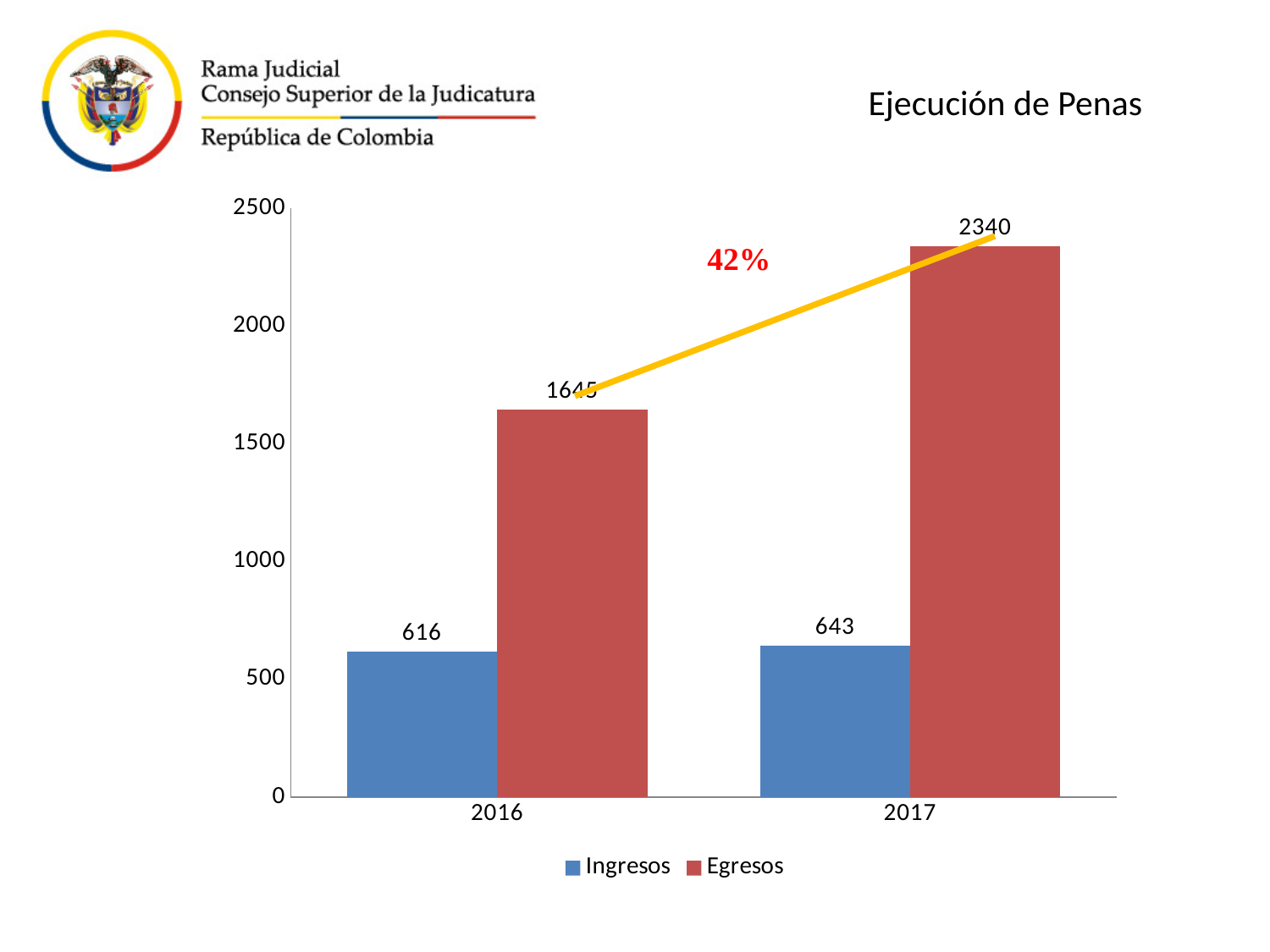
What is the value of Ingresos for 2017? 643 What is the value of Ingresos for 2016? 616 How many series does the legend list? 2 What kind of chart is shown on the slide? Bar chart Which bar has the lowest value in the chart? Ingresos in 2016 Which is larger in 2016, Ingresos or Egresos? Egresos Which year has the highest Egresos value? 2017 What is the value of Egresos for 2017? 2340 What percentage is written in red next to the yellow arrow on the chart? 42% By how much did Ingresos increase from 2016 to 2017? 27 What is the difference between Egresos and Ingresos in 2017? 1697 What is the value of Egresos for 2016? 1645